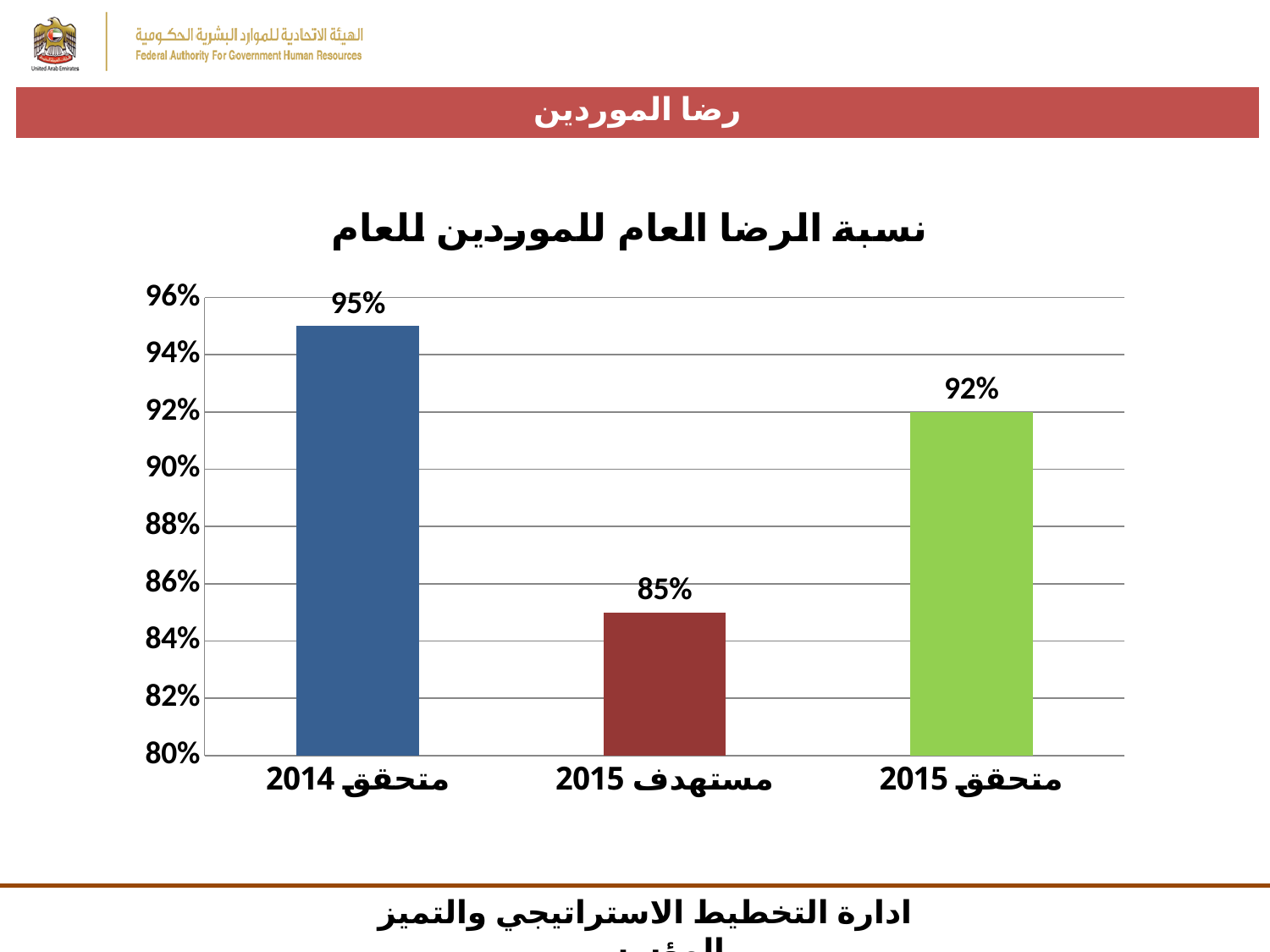
What is the value for متحقق 2015? 92% Which is larger, the value for متحقق 2015 or the value for مستهدف 2015? متحقق 2015 What is the value for مستهدف 2015? 85% Which category has the lowest value? مستهدف 2015 Which category has the highest value? متحقق 2014 What kind of chart is shown on the slide? bar chart What is the difference between the values for متحقق 2014 and متحقق 2015? 3% How many categories are shown on the x axis? 3 What is the difference between the values for متحقق 2015 and مستهدف 2015? 7% What is the title of the chart? نسبة الرضا العام للموردين للعام Is the value for مستهدف 2015 greater or less than 90%? less What is the value for متحقق 2014? 95%